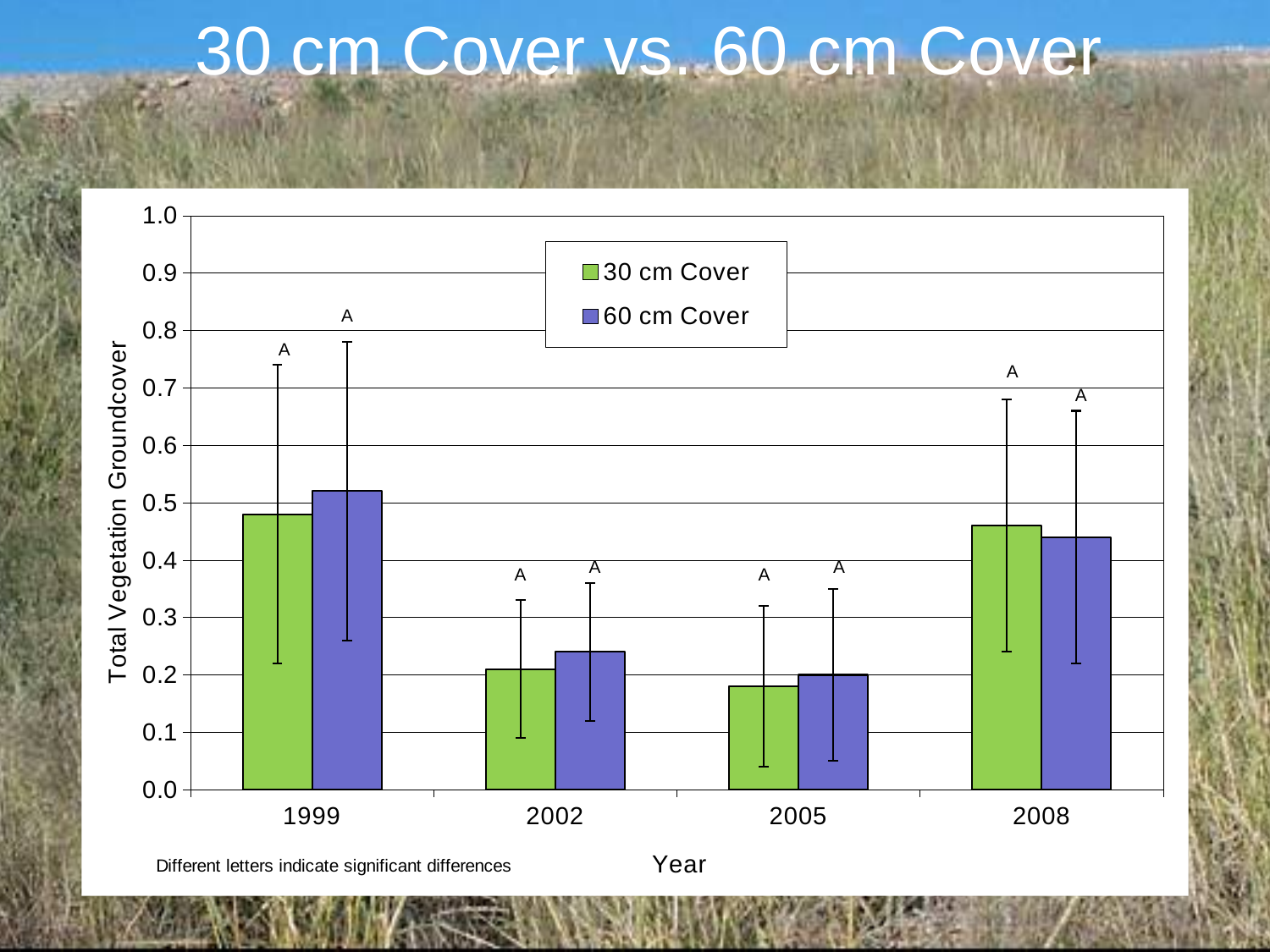
Is the value for 60 cm Cover in 2008 greater or less than 0.4? greater How many series does the legend list? 2 Is the value for 60 cm Cover in 1999 greater or less than 0.5? greater Which is larger in 1999, the value for 30 cm Cover or 60 cm Cover? 60 cm Cover Do the values for 30 cm Cover rise or fall from 1999 to 2005? fall What kind of chart is shown on the slide? bar chart Is the value for 30 cm Cover in 2008 greater or less than 0.5? less Which year has the highest value for 60 cm Cover? 1999 How many years are shown on the x axis? 4 Which year has the lowest value for 60 cm Cover? 2005 What is the label of the y axis? Total Vegetation Groundcover